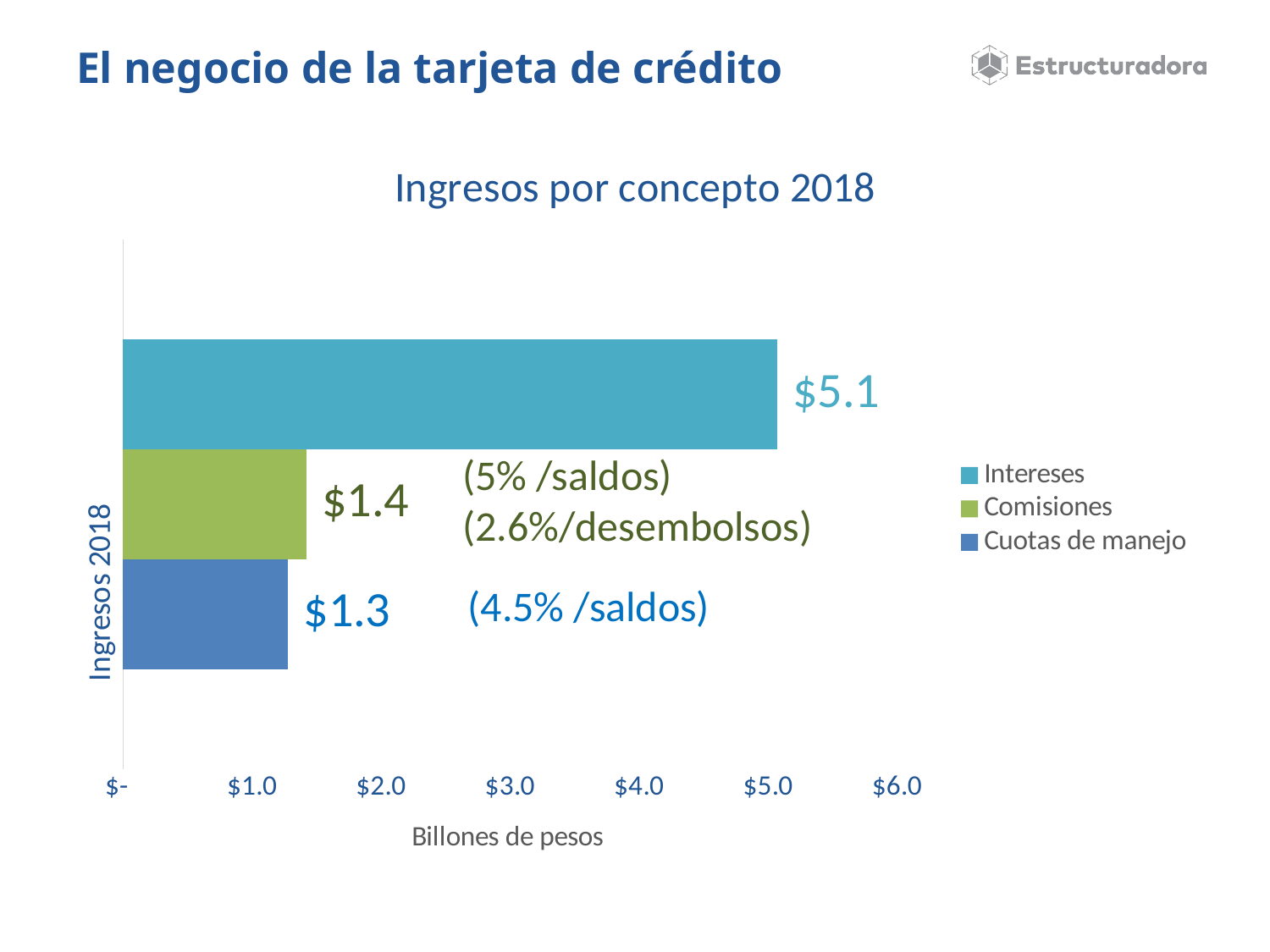
What is the difference between Intereses and Comisiones? $3.7 What is the value for Comisiones? $1.4 Which is larger, Intereses or Cuotas de manejo? Intereses What kind of chart is shown? bar chart What is the difference between Intereses and Cuotas de manejo? $3.8 What is the value for Cuotas de manejo? $1.3 What is the x-axis label of the chart? Billones de pesos How many series does the legend list? 3 Is the value for Intereses greater or less than $5.0? greater What is the value for Intereses? $5.1 What is the title of the chart? Ingresos por concepto 2018 Which series has the highest value? Intereses